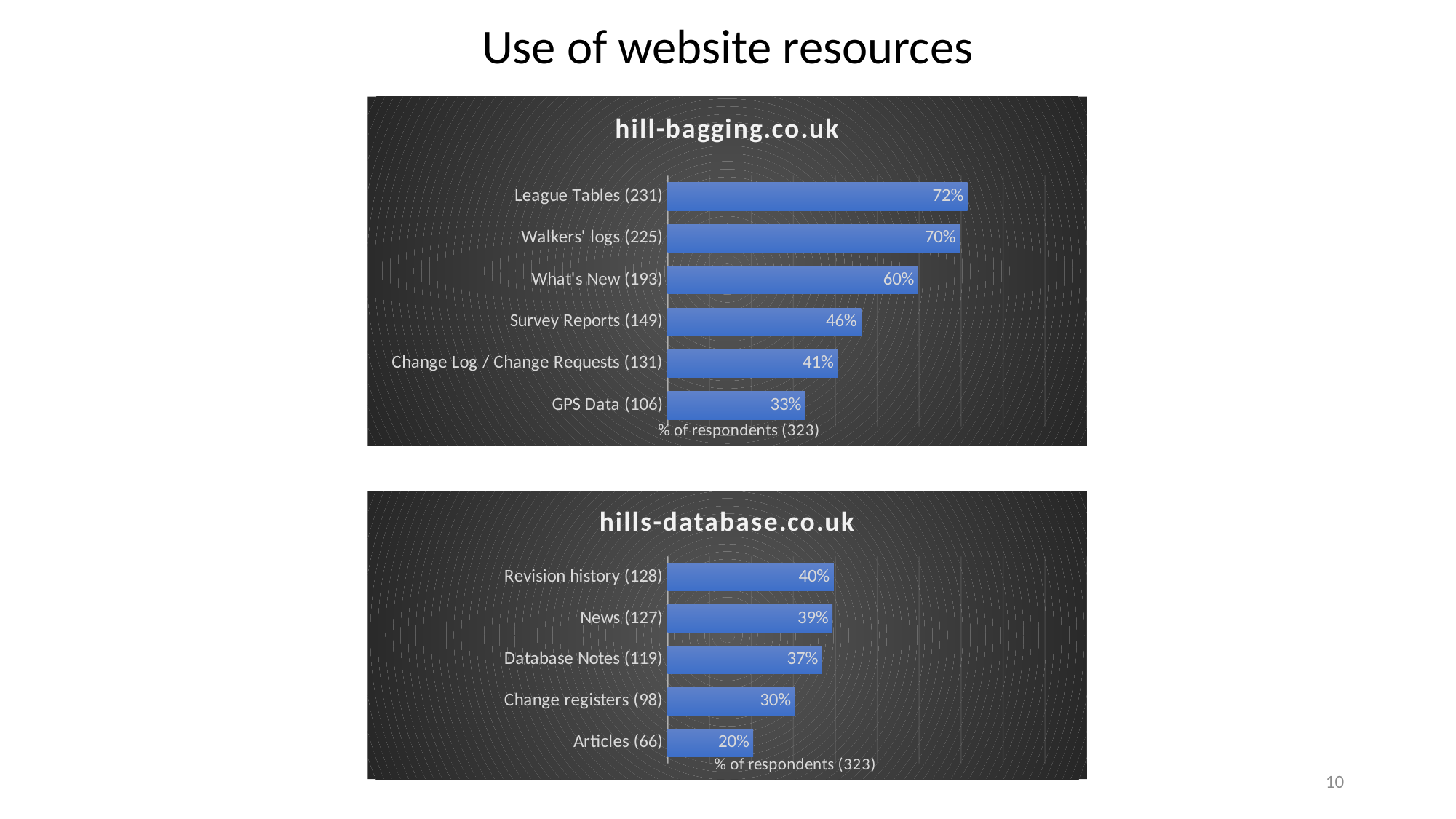
In the hills-database.co.uk chart, which category has the lowest value? Articles (66) In the hills-database.co.uk chart, what is the difference between the values for Revision history and Articles? 20% In the hills-database.co.uk chart, what percentage of respondents use Database Notes? 37% In the hill-bagging.co.uk chart, what percentage of respondents use League Tables? 72% How many categories are shown in the hills-database.co.uk chart? 5 In the hill-bagging.co.uk chart, which category has the highest value? League Tables (231) What is the title of the top chart on the slide? hill-bagging.co.uk In the hill-bagging.co.uk chart, which is larger: the value for Survey Reports or the value for Change Log / Change Requests? Survey Reports In the hill-bagging.co.uk chart, what is the difference between the values for What's New and Survey Reports? 14% What type of chart is the hills-database.co.uk chart? Bar chart How many categories are shown in the hill-bagging.co.uk chart? 6 In the hill-bagging.co.uk chart, what is the value for GPS Data? 33%